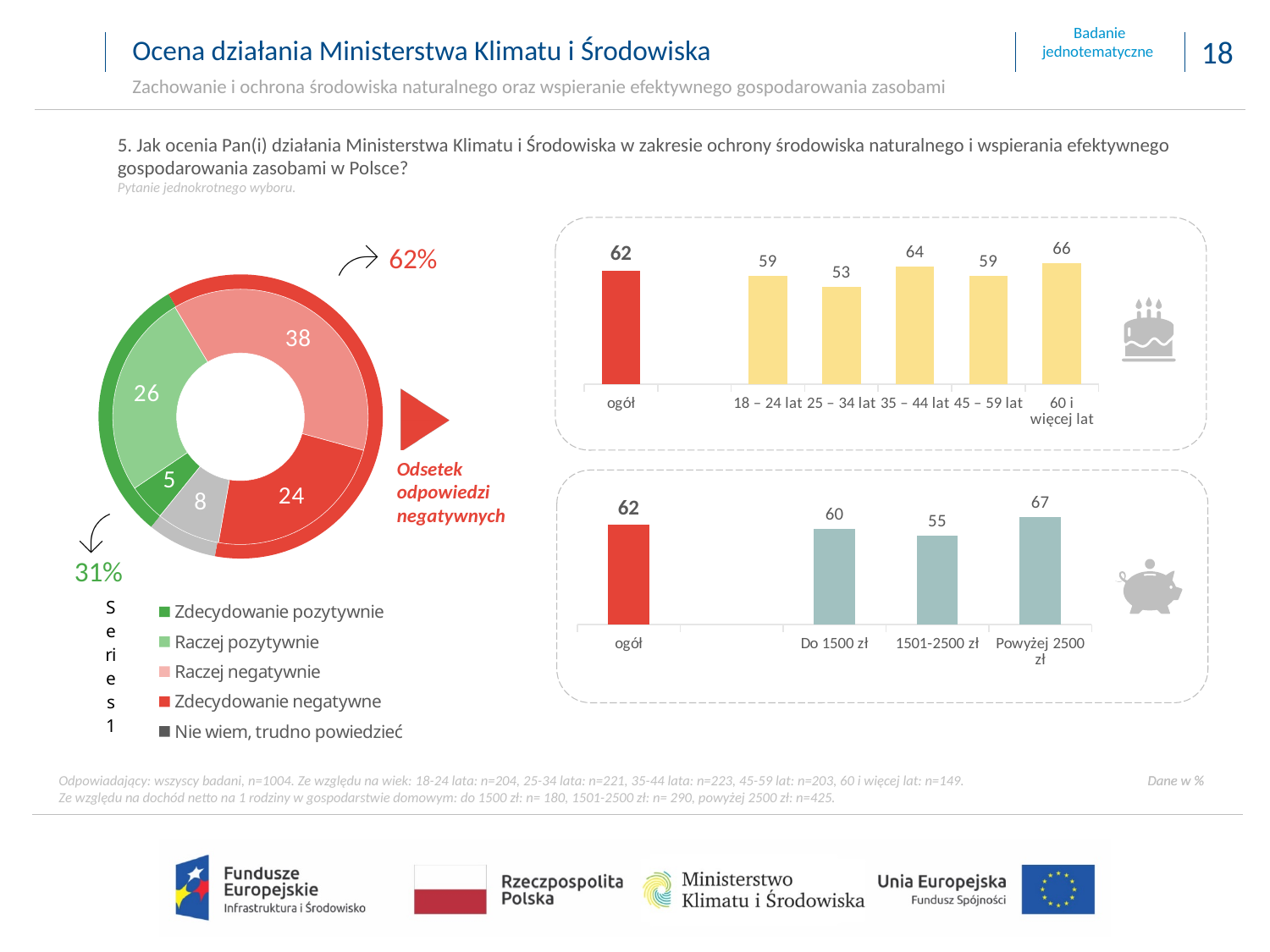
What type of chart is the bottom-right chart by income? Bar chart In the donut chart on the left, what is the value for 'Raczej negatywnie'? 38 In the top-right bar chart by age, which age group has the lowest value? 25 – 34 lat In the donut chart on the left, which category has the largest value? Raczej negatywnie In the donut chart on the left, what is the value for 'Zdecydowanie pozytywnie'? 5 In the bottom-right bar chart by income, which is larger: 'Do 1500 zł' or '1501-2500 zł'? Do 1500 zł How many bars are shown in the top-right bar chart by age? 6 How many entries does the legend of the donut chart on the left list? 5 In the top-right bar chart by age, what is the difference between 'ogół' and '25 – 34 lat'? 9 In the bottom-right bar chart by income, what is the value for 'Powyżej 2500 zł'? 67 In the top-right bar chart by age, what is the value for '60 i więcej lat'? 66 What percentage of negative responses is indicated next to the donut chart on the left? 62%